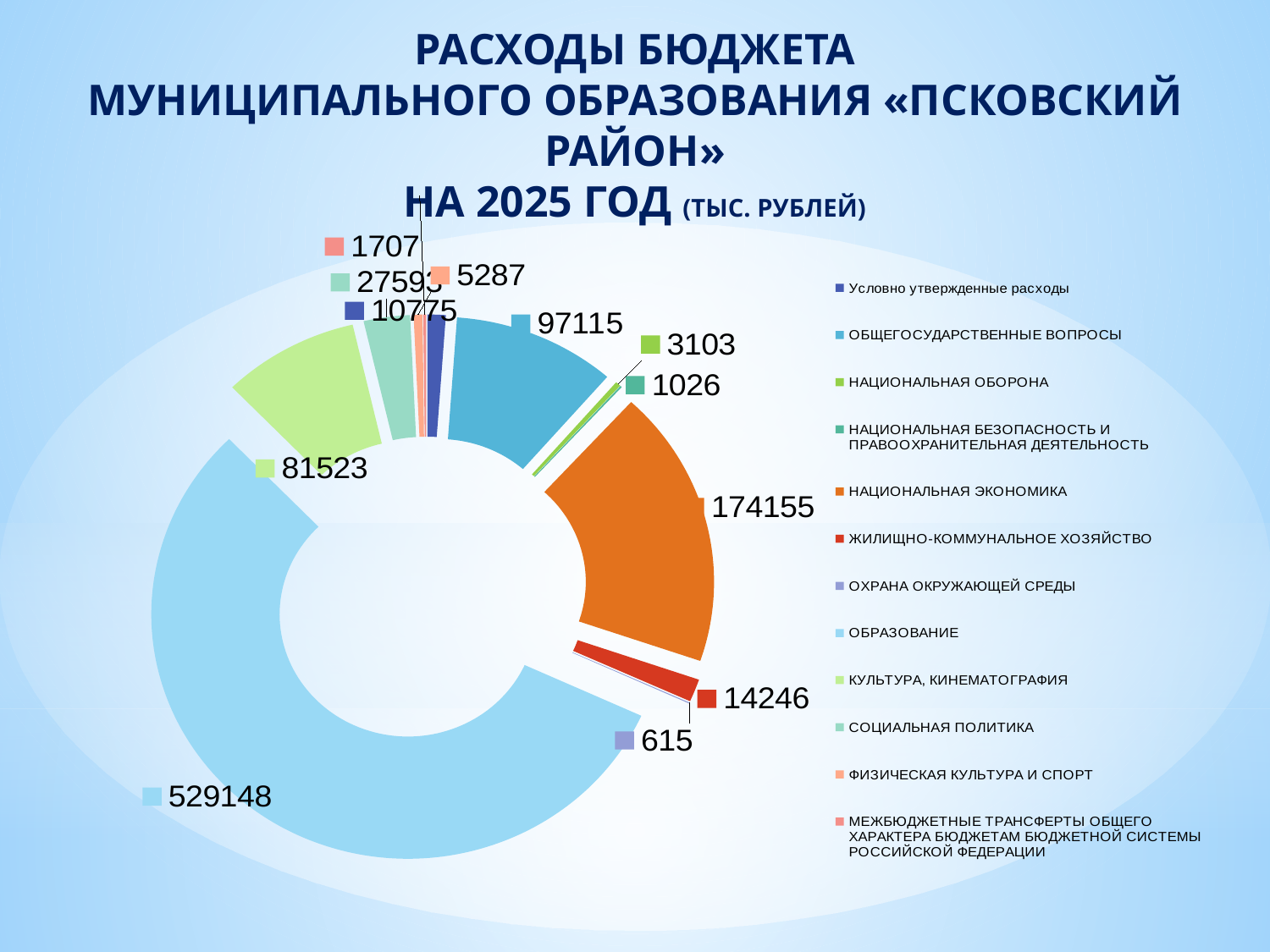
How many categories does the legend list? 12 What is the value for КУЛЬТУРА, КИНЕМАТОГРАФИЯ? 81523 What is the value for НАЦИОНАЛЬНАЯ ЭКОНОМИКА? 174155 Which is larger: КУЛЬТУРА, КИНЕМАТОГРАФИЯ or ЖИЛИЩНО-КОММУНАЛЬНОЕ ХОЗЯЙСТВО? КУЛЬТУРА, КИНЕМАТОГРАФИЯ What is the value for ОБЩЕГОСУДАРСТВЕННЫЕ ВОПРОСЫ? 97115 What is the value for ОХРАНА ОКРУЖАЮЩЕЙ СРЕДЫ? 615 What is the value for ОБРАЗОВАНИЕ? 529148 Which category has the smallest value? ОХРАНА ОКРУЖАЮЩЕЙ СРЕДЫ What type of chart is shown on the slide? Doughnut (pie) chart Which category has the largest value? ОБРАЗОВАНИЕ What is the difference between the values for НАЦИОНАЛЬНАЯ ЭКОНОМИКА and ОБЩЕГОСУДАРСТВЕННЫЕ ВОПРОСЫ? 77040 What is the value for ЖИЛИЩНО-КОММУНАЛЬНОЕ ХОЗЯЙСТВО? 14246